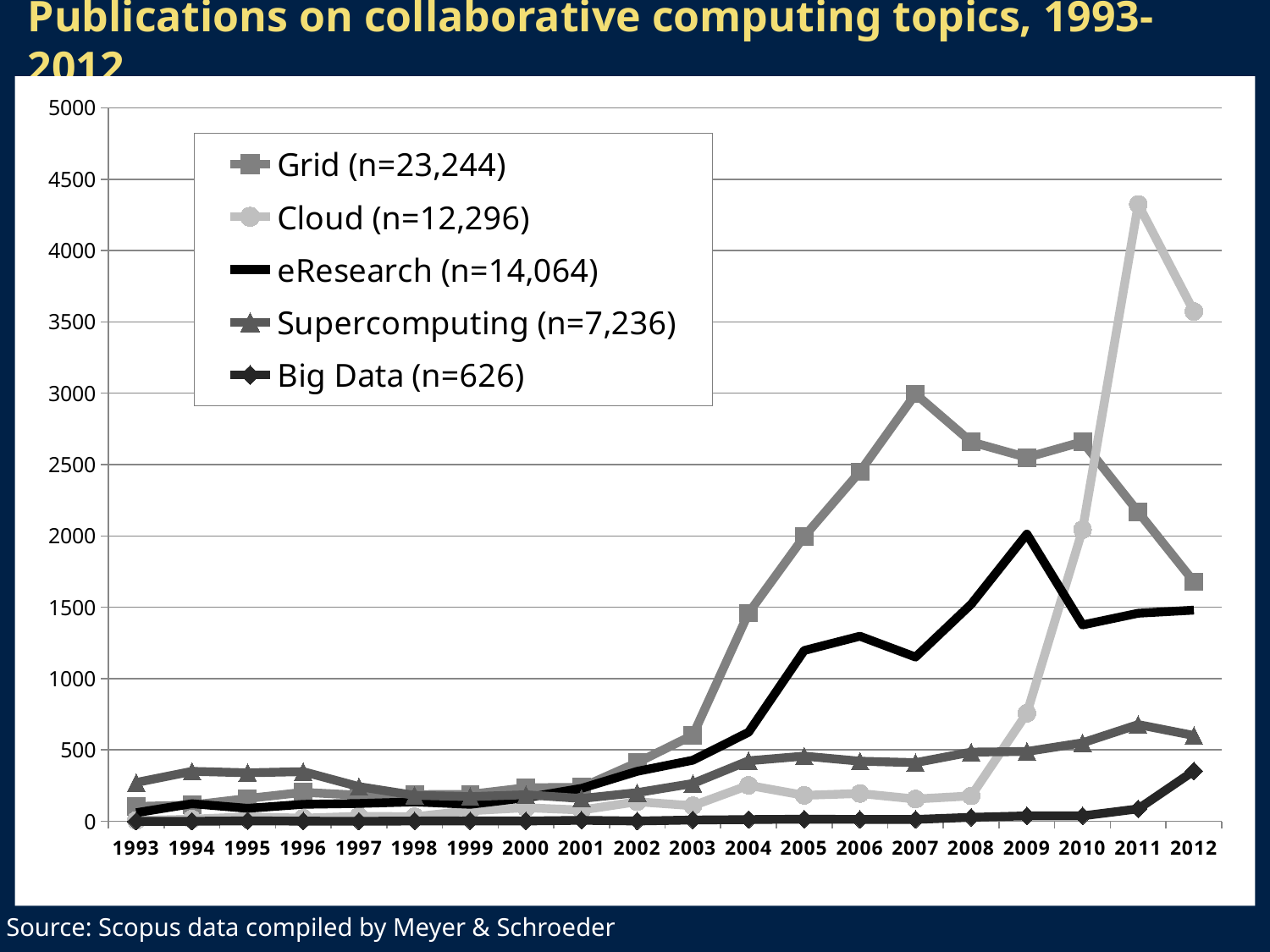
In 2012, which is larger: the value for Grid or the value for eResearch? Grid Which series has the highest value in 2011? Cloud Does the Grid series rise or fall from 2007 to 2012? fall Is the value for Big Data in 2012 greater or less than 500? less Is the value for Grid in 2007 greater or less than 2500? greater Which series has the lowest value in 2005? Big Data How many years are plotted along the x axis? 20 How many series does the legend list? 5 What n value does the legend give for Grid? n=23,244 Does the Cloud series rise or fall from 2009 to 2011? rise What kind of chart is shown on the slide? line chart Is the value for Cloud in 2011 greater or less than 4000? greater